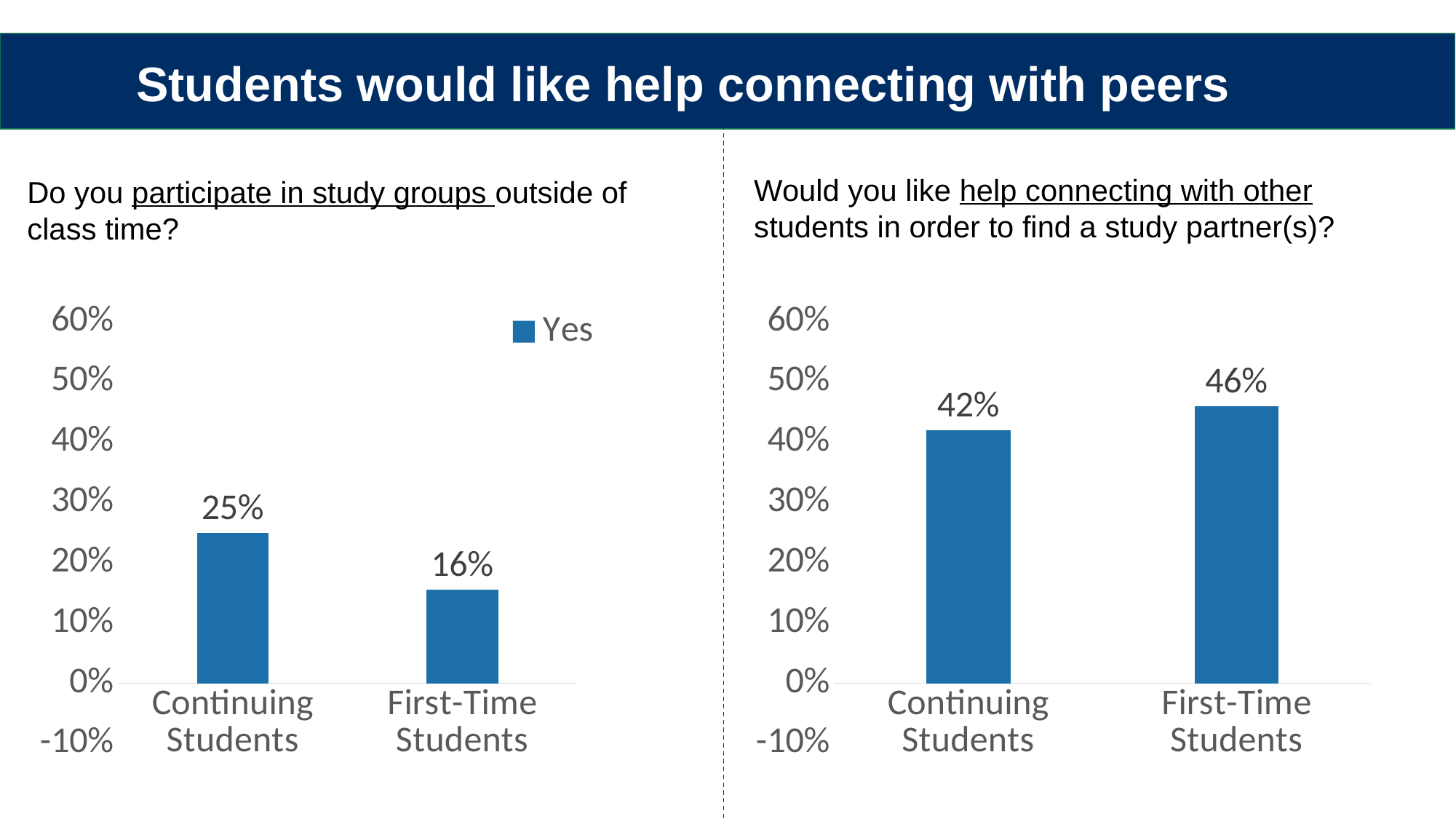
In the left chart (study groups), what is the value for First-Time Students? 16% What kind of chart is the right chart (help connecting)? Bar chart How many categories are shown in the left chart (study groups)? 2 In the left chart (study groups), what is the value for Continuing Students? 25% In the right chart (help connecting), is the value for First-Time Students greater or less than 40%? greater In the right chart (help connecting), what is the difference between First-Time Students and Continuing Students? 4% In the left chart (study groups), what is the difference between Continuing Students and First-Time Students? 9% In the right chart (help connecting), which category has the lowest value? Continuing Students In the left chart (study groups), which category has the highest value? Continuing Students How many series does the legend of the left chart (study groups) list? 1 In the right chart (help connecting), what is the value for First-Time Students? 46% In the right chart (help connecting), what is the value for Continuing Students? 42%